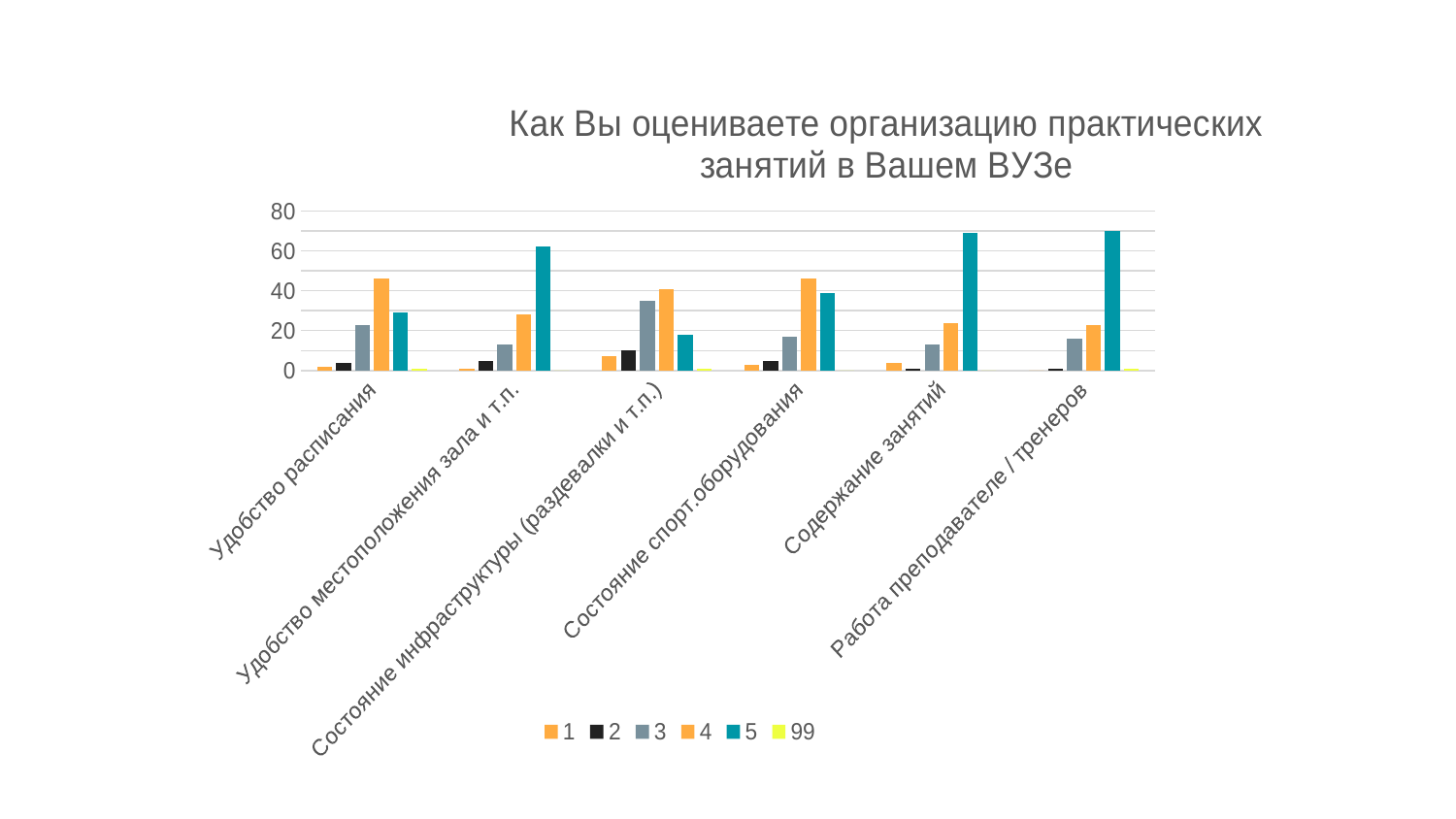
What kind of chart is shown on the slide? Bar chart How many categories are shown on the x axis of the chart? 6 What is the title of the chart? Как Вы оцениваете организацию практических занятий в Вашем ВУЗе Which series labels are listed in the legend? 1, 2, 3, 4, 5, 99 How many series does the legend list? 6 Which category has the highest value for series 3? Состояние инфраструктуры (раздевалки и т.п.) For "Удобство расписания", which is larger: the value of series 4 or series 5? Series 4 Is the value of series 3 for "Состояние инфраструктуры (раздевалки и т.п.)" greater or less than 40? less Is the value of series 5 for "Содержание занятий" greater or less than 60? greater Which is larger: the value of series 5 for "Удобство местоположения зала и т.п." or for "Удобство расписания"? Удобство местоположения зала и т.п. Which category has the lowest value for series 5? Состояние инфраструктуры (раздевалки и т.п.) Is the value of series 5 for "Удобство местоположения зала и т.п." greater or less than 40? greater